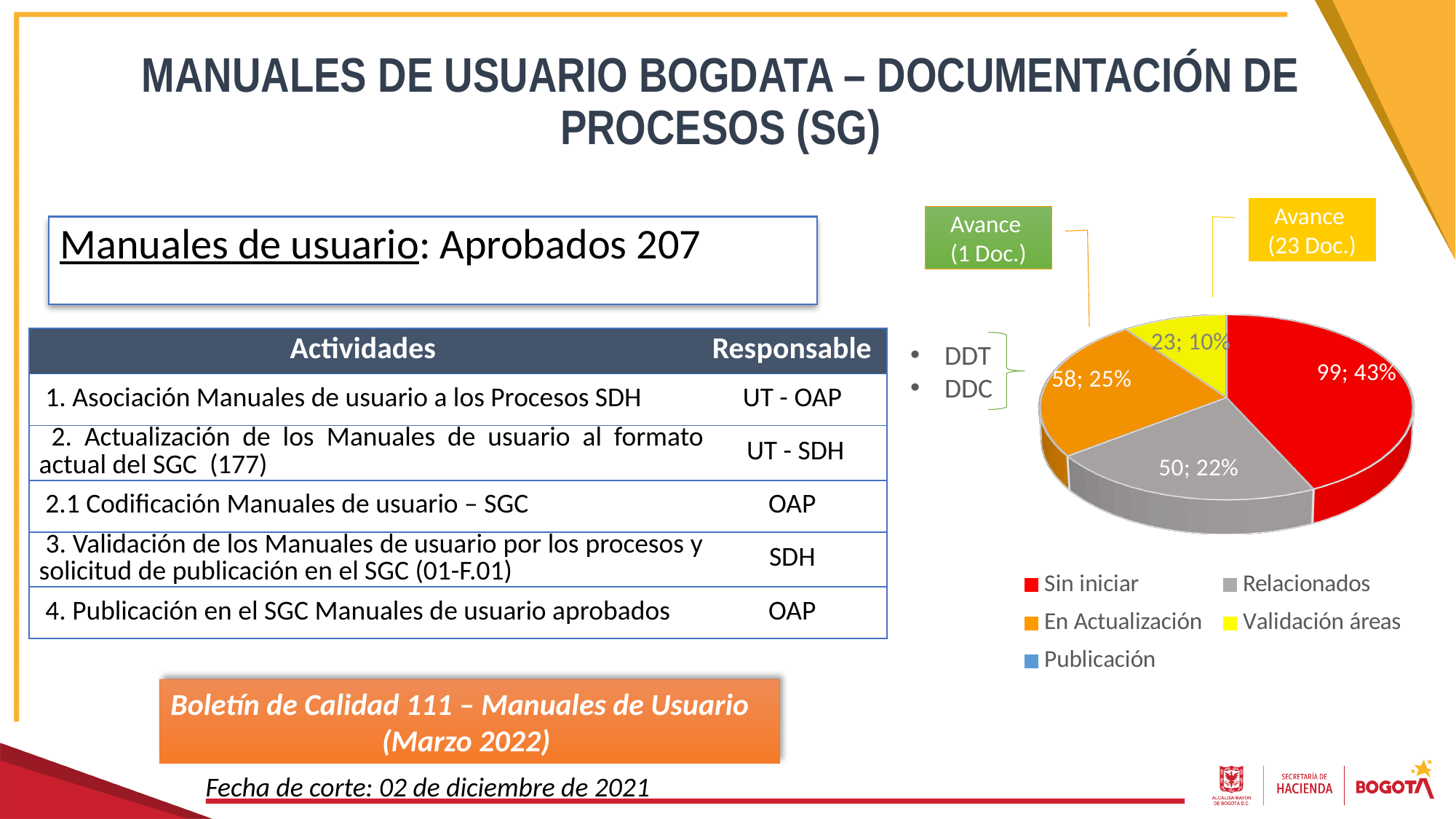
Which labelled slice in the pie chart is the smallest? Validación áreas What is the difference between the counts for 'Sin iniciar' and 'En Actualización' in the pie chart? 41 What colour is used for the 'Validación áreas' slice in the pie chart? yellow In the pie chart, which is larger: 'En Actualización' or 'Relacionados'? En Actualización In the pie chart, what value is shown for the 'En Actualización' slice? 58; 25% What kind of chart is shown on the right side of the slide? pie chart How many entries does the legend of the pie chart list? 5 In the pie chart, what value is shown for the 'Validación áreas' slice? 23; 10% In the pie chart, what value is shown for the 'Relacionados' slice? 50; 22% What percentage share of the pie does 'Relacionados' represent? 22% Which category has the largest slice in the pie chart? Sin iniciar In the pie chart, what value is shown for the 'Sin iniciar' slice? 99; 43%